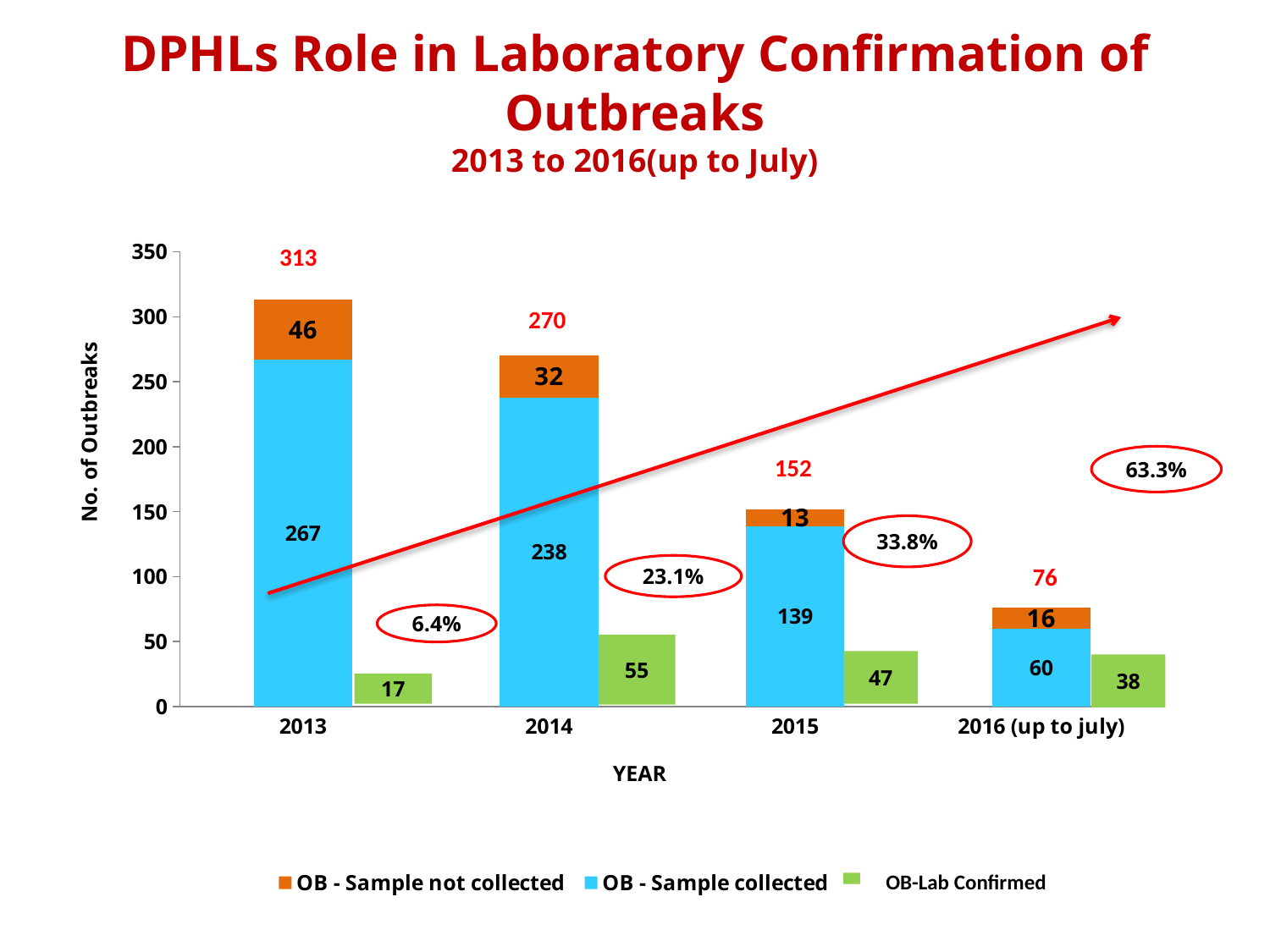
What is the value for OB - Sample collected in 2013? 267 Do the stacked bar totals rise or fall from 2013 to 2016 (up to july)? Fall What is the value for OB - Sample not collected in 2016 (up to july)? 16 How many years are shown on the x axis? 4 What is the value for OB-Lab Confirmed in 2014? 55 Which year has the lowest value for OB-Lab Confirmed? 2013 What is the total of the stacked bar for 2014? 270 How many series does the legend list? 3 What kind of chart is shown? Bar chart Which is larger, the OB-Lab Confirmed value for 2015 or for 2016 (up to july)? 2015 Which year has the highest total of the stacked bar? 2013 What is the difference between the OB - Sample collected values for 2014 and 2015? 99